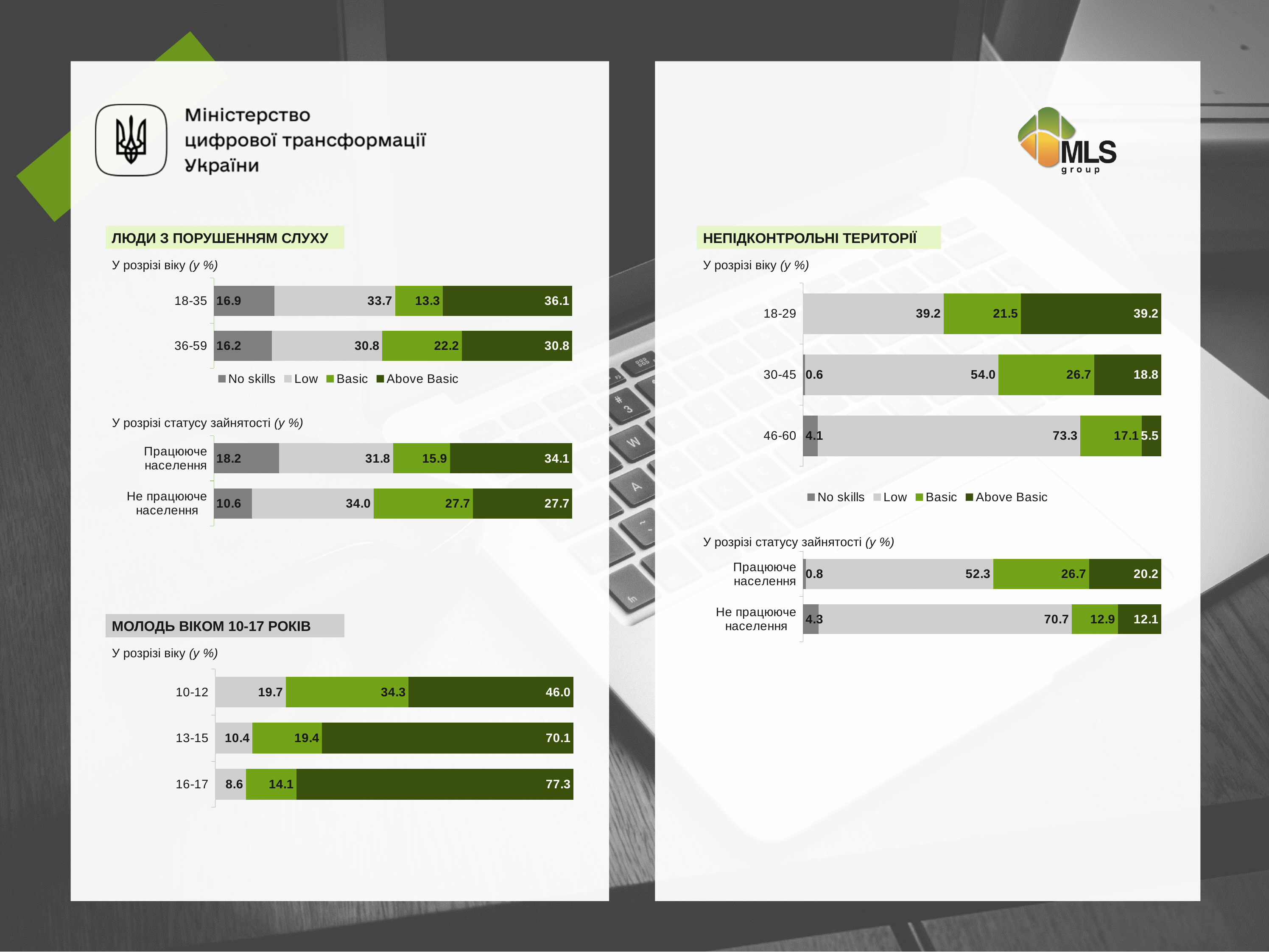
In the 'ЛЮДИ З ПОРУШЕННЯМ СЛУХУ' age chart (У розрізі віку), what is the Above Basic value for the 18-35 group? 36.1 What type of chart is used in the 'ЛЮДИ З ПОРУШЕННЯМ СЛУХУ' age section? Stacked bar chart In the 'МОЛОДЬ ВІКОМ 10-17 РОКІВ' chart, how many age groups are shown? 3 In the 'ЛЮДИ З ПОРУШЕННЯМ СЛУХУ' employment status chart, what is the No skills value for 'Не працююче населення'? 10.6 In the 'ЛЮДИ З ПОРУШЕННЯМ СЛУХУ' employment status chart, what is the difference between the Above Basic values for 'Працююче населення' and 'Не працююче населення'? 6.4 In the 'НЕПІДКОНТРОЛЬНІ ТЕРИТОРІЇ' employment status chart, which group has the larger Low value, 'Працююче населення' or 'Не працююче населення'? Не працююче населення In the 'НЕПІДКОНТРОЛЬНІ ТЕРИТОРІЇ' age chart, which age group has the lowest Above Basic value? 46-60 In the 'НЕПІДКОНТРОЛЬНІ ТЕРИТОРІЇ' age chart, what is the Low value for the 46-60 group? 73.3 In the 'МОЛОДЬ ВІКОМ 10-17 РОКІВ' chart, which age group has the highest Above Basic value? 16-17 How many series does the legend of the 'НЕПІДКОНТРОЛЬНІ ТЕРИТОРІЇ' age chart list? 4 In the 'ЛЮДИ З ПОРУШЕННЯМ СЛУХУ' age chart, what is the Basic value for the 36-59 group? 22.2 In the 'МОЛОДЬ ВІКОМ 10-17 РОКІВ' chart, what is the Basic value for the 10-12 group? 34.3